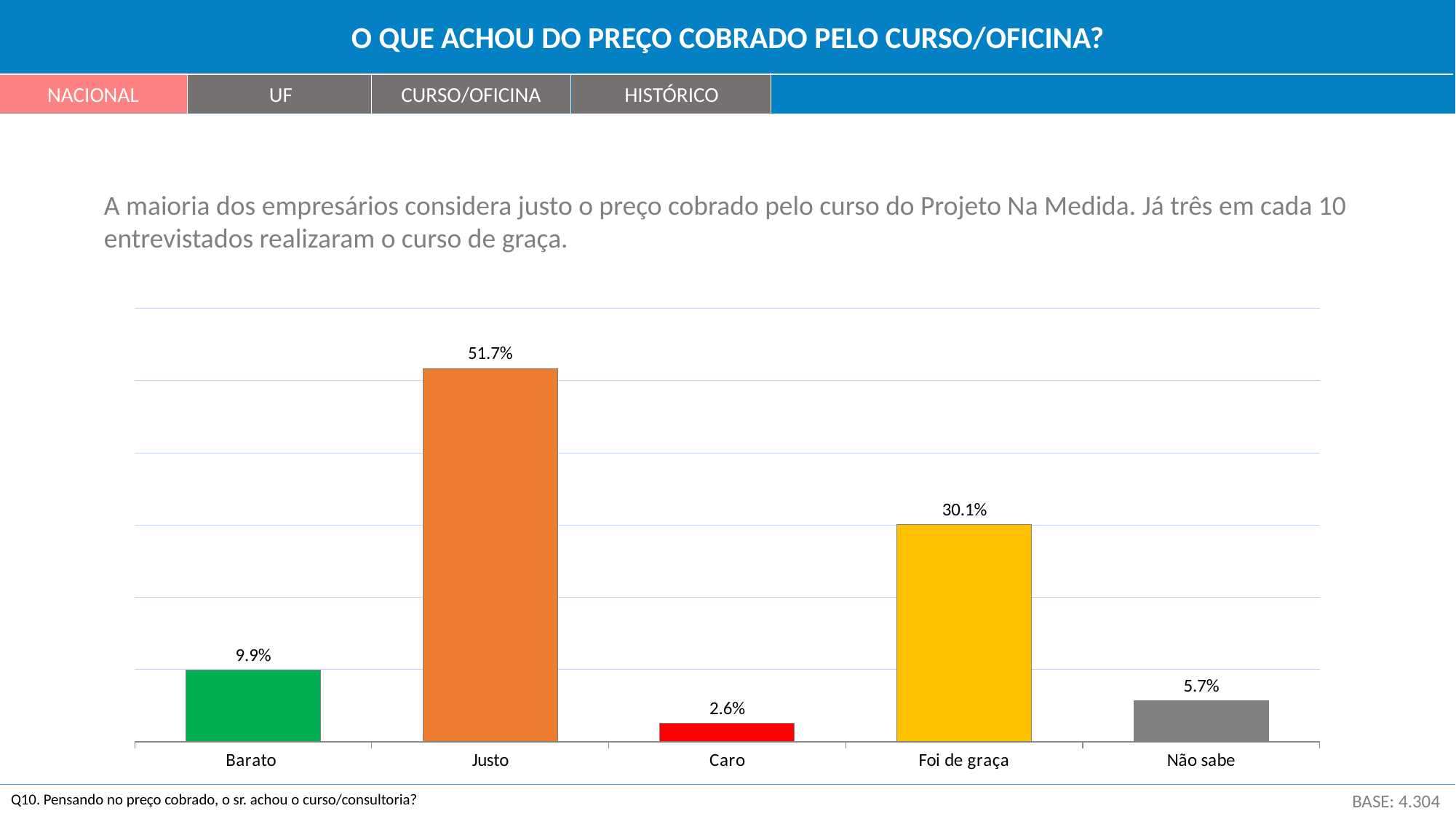
What is the value for Foi de graça? 30.1% What is the difference between the values for Justo and Foi de graça? 21.6% Which category has the lowest value? Caro What is the value for Não sabe? 5.7% What is the difference between the values for Barato and Não sabe? 4.2% How many categories are shown on the x axis? 5 What is the value for Justo? 51.7% What colour is the bar for Caro? Red Which category has the highest value? Justo What kind of chart is shown on the slide? Bar chart What is the value for Barato? 9.9% Which is larger, the value for Barato or the value for Caro? Barato